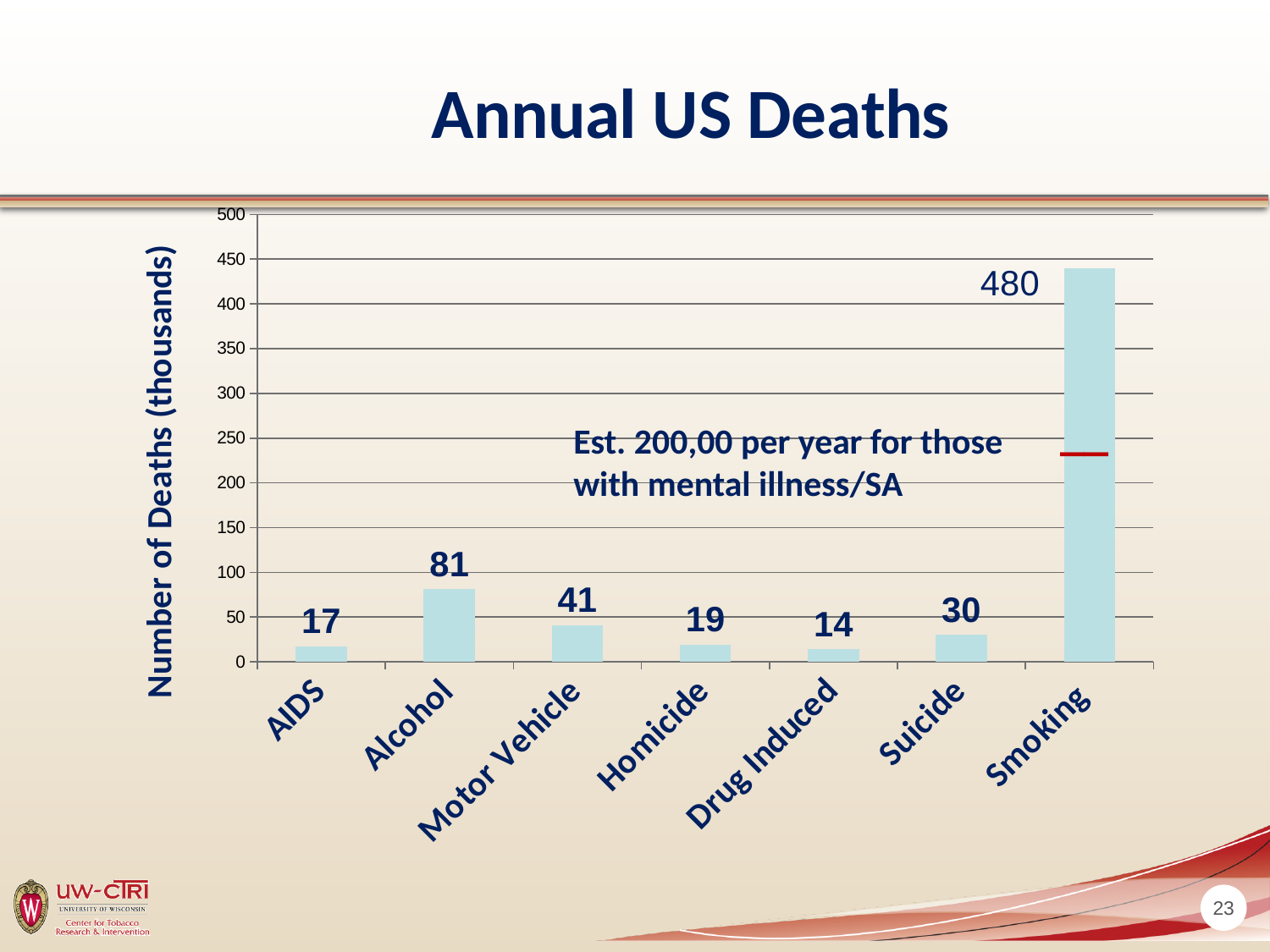
What kind of chart is shown on the slide? bar chart Which is larger, the value for Suicide or the value for Homicide? Suicide Which category has the highest number of deaths? Smoking What is the value shown for Smoking? 480 Which category has the lowest number of deaths? Drug Induced What is the value shown for Drug Induced? 14 What is the value shown for Alcohol? 81 What is the difference between the values for Alcohol and Motor Vehicle? 40 What is the title of the chart? Annual US Deaths How many categories are shown on the x axis? 7 What is the label of the vertical axis? Number of Deaths (thousands) Is the value for Smoking greater or less than 400? greater